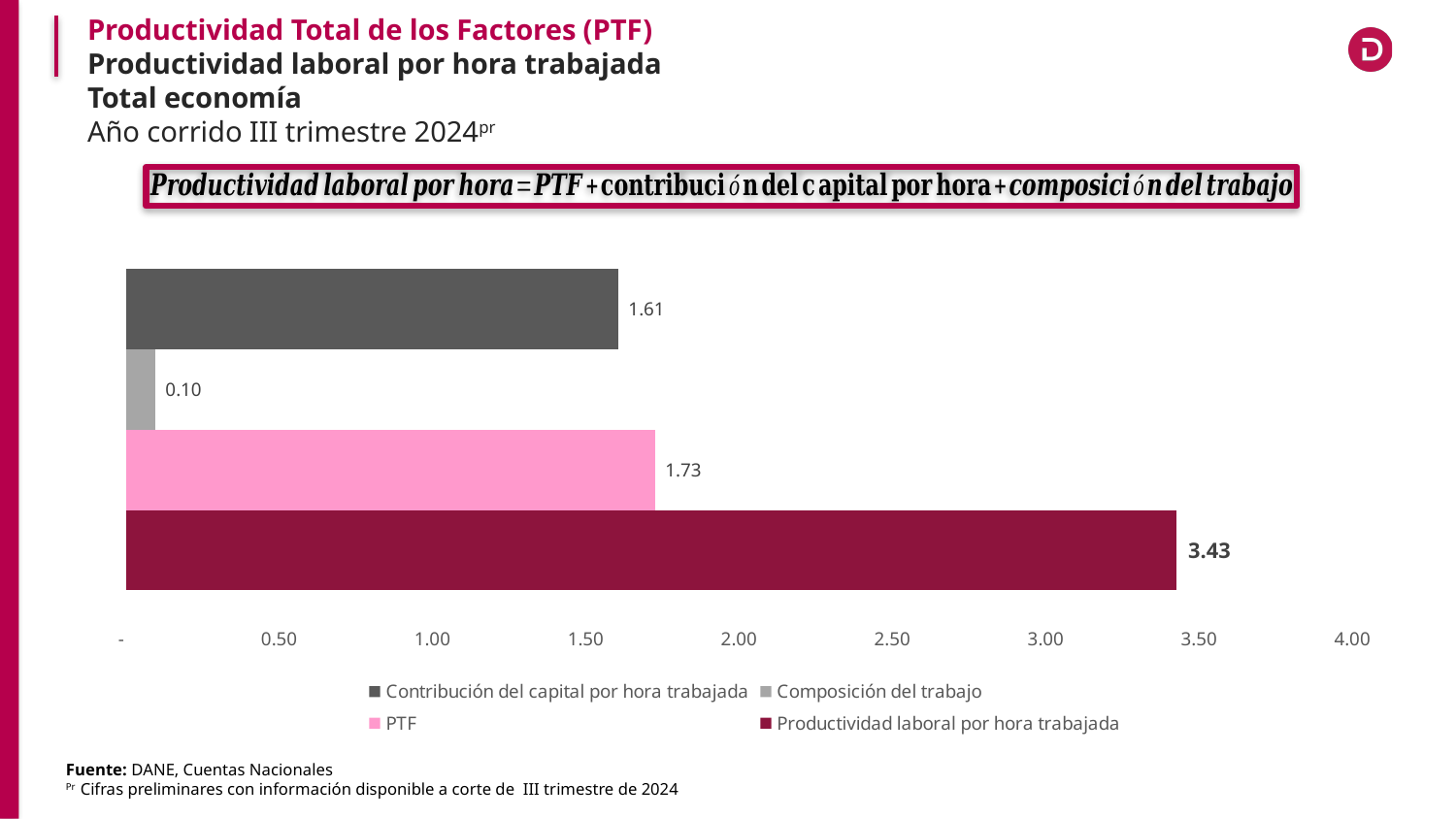
What is the value shown for Composición del trabajo? 0.10 Which is larger, the value for PTF or the value for Contribución del capital por hora trabajada? PTF Which series has the highest value? Productividad laboral por hora trabajada How many series does the legend list? 4 What kind of chart is shown on the slide? Bar chart What is the difference between the value for PTF and the value for Contribución del capital por hora trabajada? 0.12 Is the value for Productividad laboral por hora trabajada greater or less than 3.00? greater What colour is the bar for PTF? Pink What is the value shown for Contribución del capital por hora trabajada? 1.61 What is the value shown for PTF? 1.73 Which series has the lowest value? Composición del trabajo What is the value shown for Productividad laboral por hora trabajada? 3.43